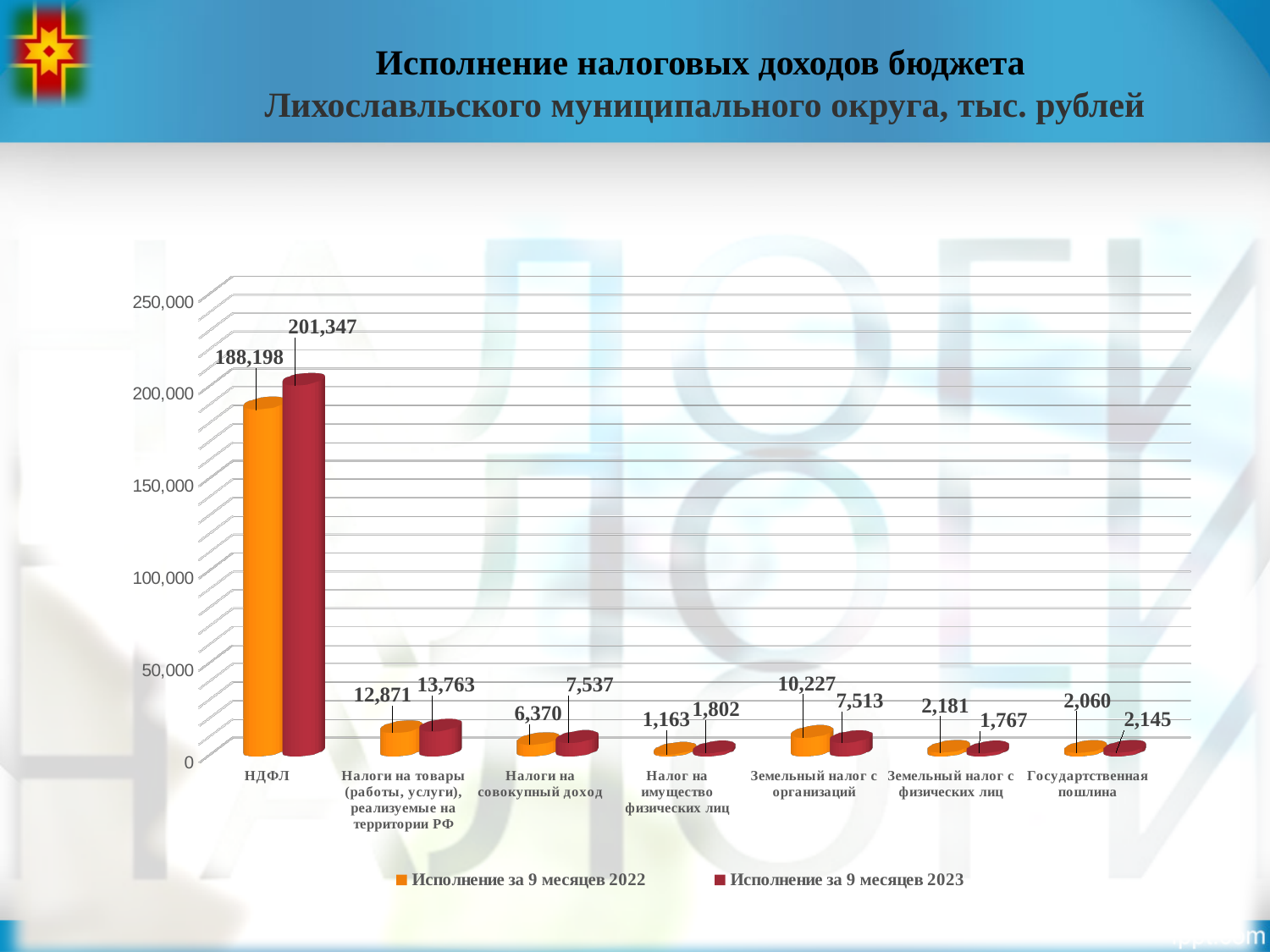
Which category has the highest value in the series Исполнение за 9 месяцев 2023? НДФЛ What is the difference between the 2022 and 2023 values for Земельный налог с организаций? 2,714 How many series does the legend list? 2 Which category has the lowest value in the series Исполнение за 9 месяцев 2022? Налог на имущество физических лиц For Земельный налог с физических лиц, which series has the larger value: Исполнение за 9 месяцев 2022 or Исполнение за 9 месяцев 2023? Исполнение за 9 месяцев 2022 What is the value for Земельный налог с организаций in the series Исполнение за 9 месяцев 2022? 10,227 What is the value for НДФЛ in the series Исполнение за 9 месяцев 2023? 201,347 What kind of chart is shown on the slide? Bar chart What is the value for Государственная пошлина in the series Исполнение за 9 месяцев 2023? 2,145 What is the difference between the 2023 and 2022 values for НДФЛ? 13,149 What is the value for НДФЛ in the series Исполнение за 9 месяцев 2022? 188,198 How many categories are shown on the x axis? 7